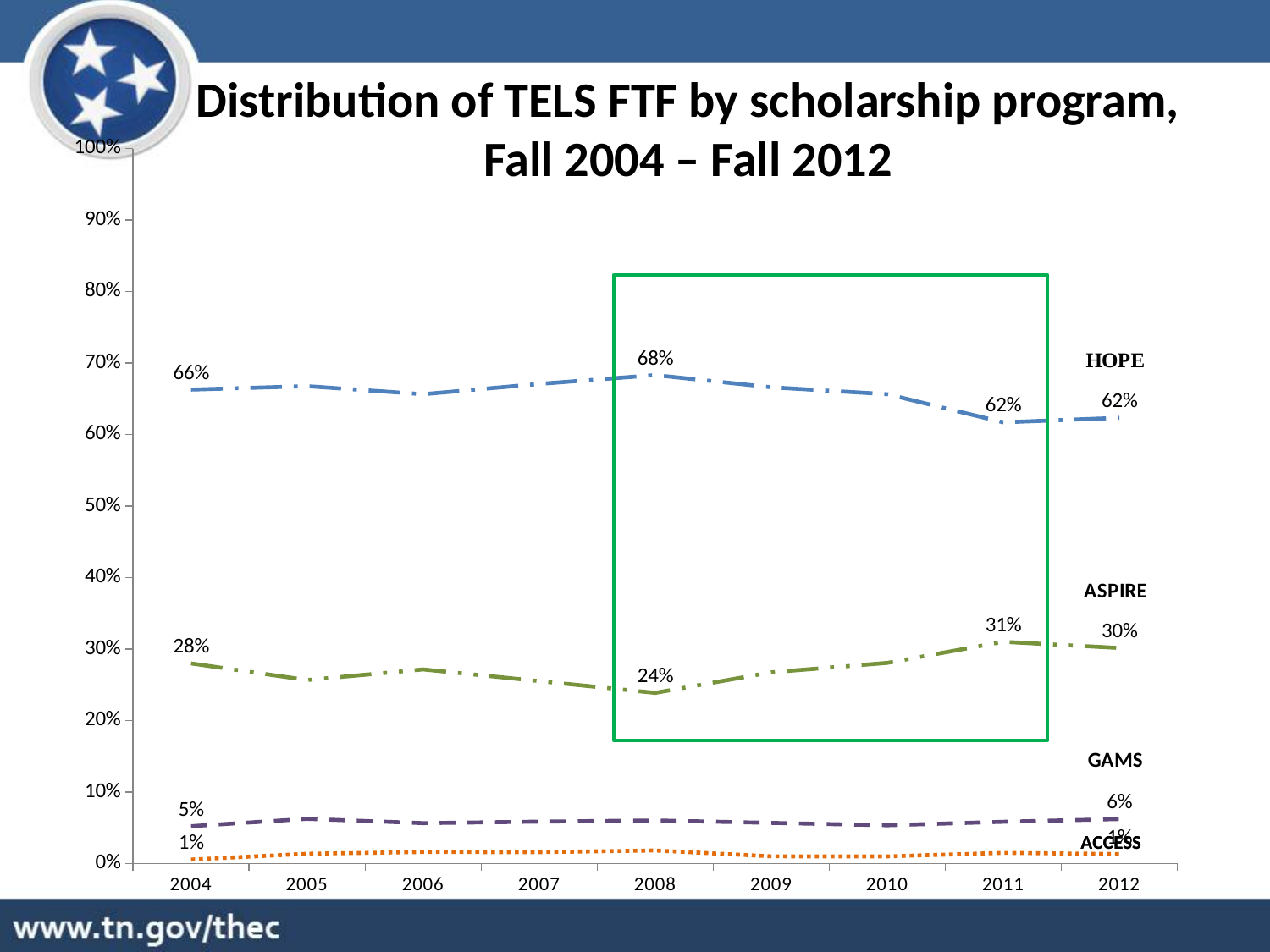
Which scholarship program has the highest share in 2012? HOPE Which scholarship program has the lowest share in 2004? ACCESS What is the value for HOPE in 2004? 66% What is the value for ASPIRE in 2011? 31% What is the difference between the HOPE value in 2008 and the HOPE value in 2012? 6% Which is larger, the ASPIRE value in 2004 or the ASPIRE value in 2008? 2004 What is the value for ACCESS in 2004? 1% What is the value for GAMS in 2012? 6% What is the value for HOPE in 2008? 68% What kind of chart is shown on the slide? Line chart How many years are shown on the x axis? 9 Is the value for HOPE in 2010 greater or less than 60%? greater